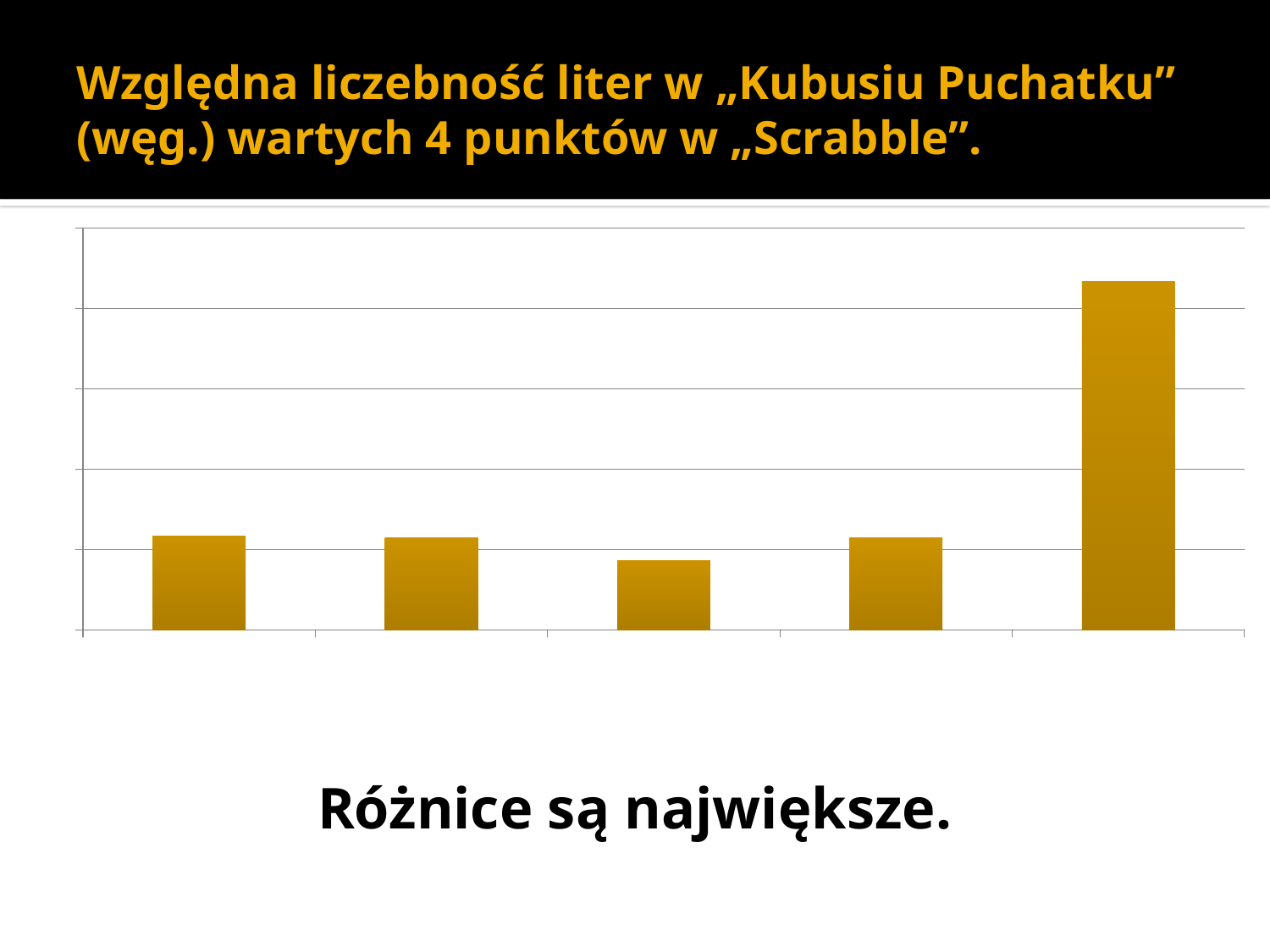
Is the fourth bar from the left taller or shorter than the fifth bar? shorter Which bar is the shortest in the chart, counting from the left? the third (middle) bar Is the rightmost bar taller or shorter than the leftmost bar? taller What colour are the bars in the chart? gold/orange What kind of chart is shown on the slide? bar chart Which bar is the tallest in the chart, counting from the left? the fifth (rightmost) bar Is the first bar from the left taller or shorter than the third bar? taller How many bars does the chart contain? 5 What is the title of the slide containing the chart? Względna liczebność liter w „Kubusiu Puchatku” (węg.) wartych 4 punktów w „Scrabble”.